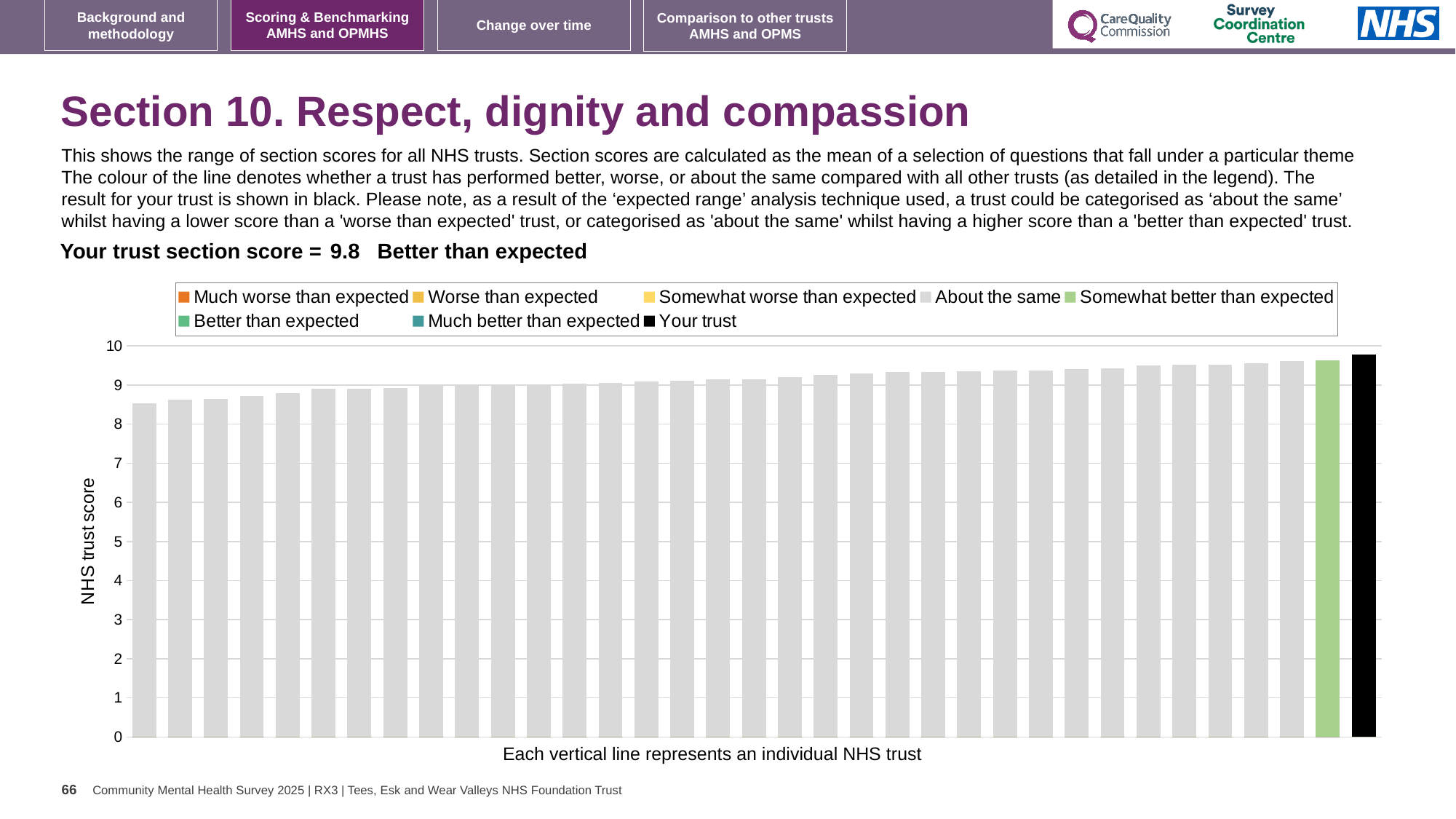
Is the value of the leftmost (lowest) bar greater or less than 8? greater Do the bar values rise or fall from left to right along the x axis? rise Which category is your trust placed in for this section? Better than expected Is the value of the leftmost (lowest) bar greater or less than 9? less How many bars are coloured light green (Somewhat better than expected)? 1 Is the value of the black 'Your trust' bar greater or less than 9? greater How many entries does the chart legend list? 8 What kind of chart is shown on the slide? bar chart Which bar is the highest in the chart? Your trust (the black bar) What is the label on the y axis of the chart? NHS trust score What is the section score for your trust shown on the slide? 9.8 What colour is the bar representing your trust? black